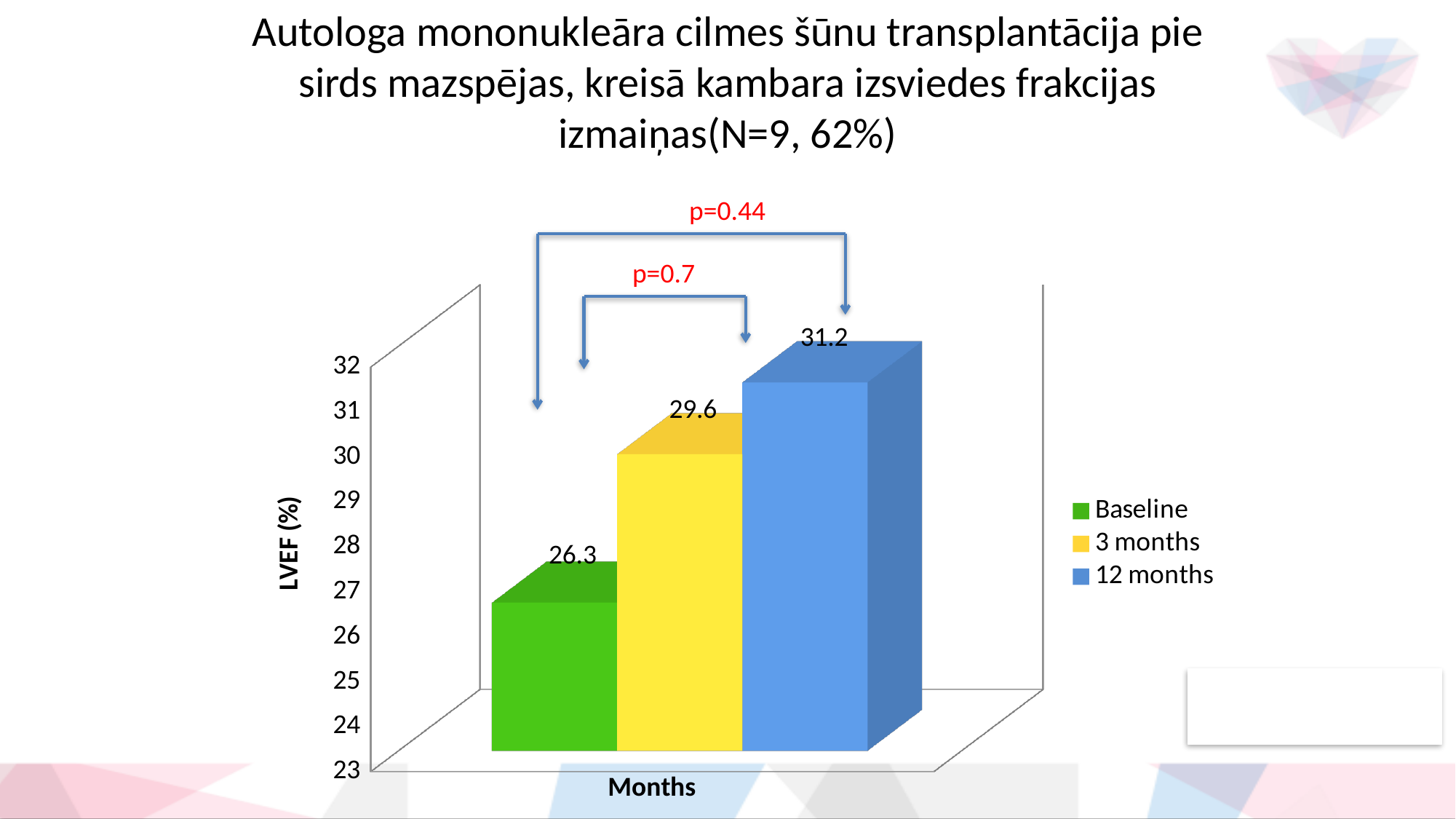
How many bars are plotted in the chart? 3 Which time point has the highest LVEF value? 12 months How many series does the legend list? 3 What is the LVEF value at 12 months? 31.2 What kind of chart is shown on the slide? Bar chart What is the LVEF value at Baseline? 26.3 What is the difference between the 3 months and Baseline LVEF values? 3.3 Do the LVEF values rise or fall from Baseline to 12 months? Rise What is the LVEF value at 3 months? 29.6 Which is larger, the LVEF value at 3 months or at 12 months? 12 months Which time point has the lowest LVEF value? Baseline What is the difference between the 12 months and Baseline LVEF values? 4.9